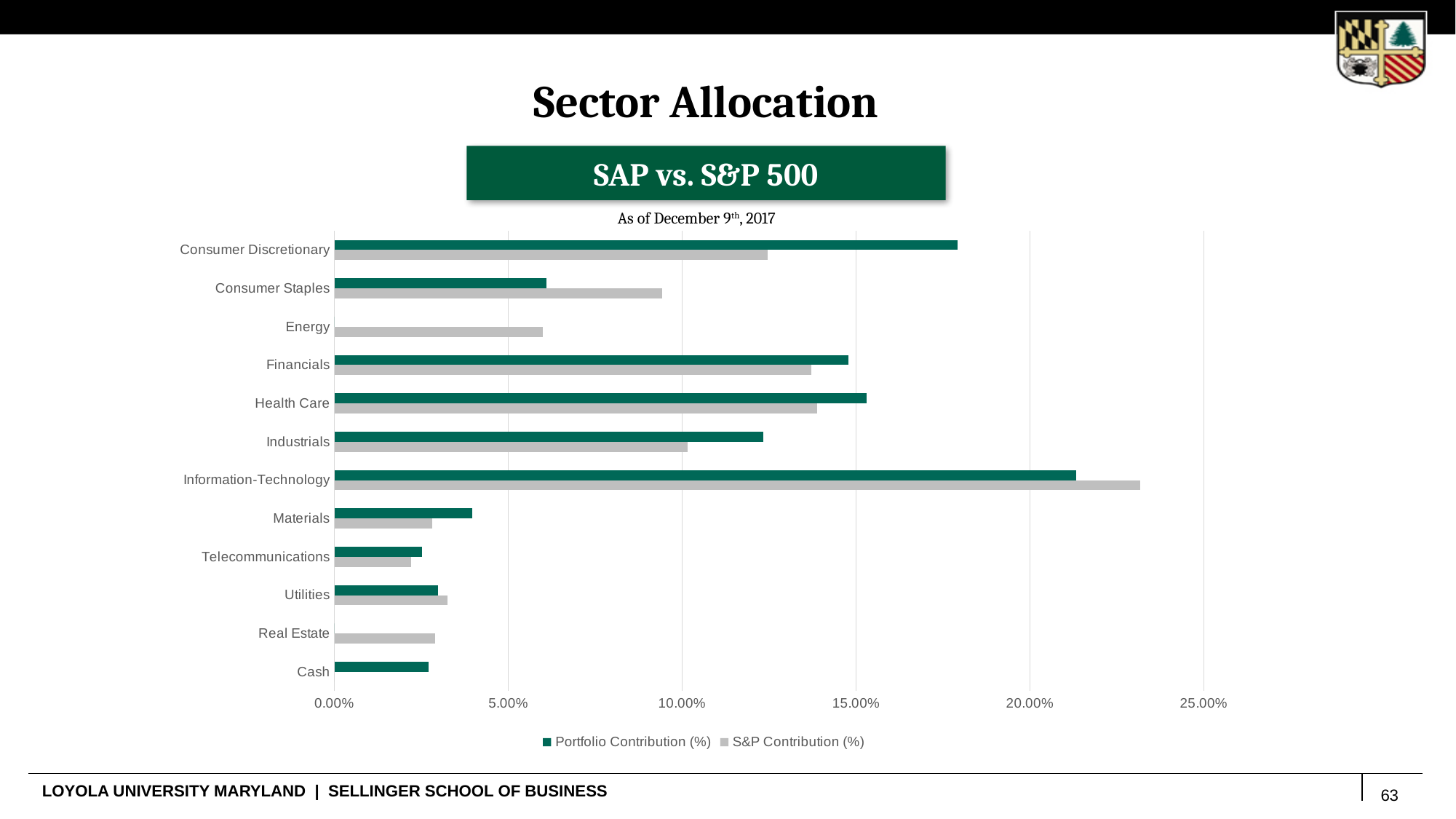
What is the title shown in the green banner above the chart? SAP vs. S&P 500 Is the S&P Contribution (%) for Consumer Staples greater or less than 10.00%? less What kind of chart is shown on the slide? Bar chart Is the Portfolio Contribution (%) for Industrials greater or less than 10.00%? greater For Consumer Staples, which is larger: Portfolio Contribution (%) or S&P Contribution (%)? S&P Contribution (%) Is the S&P Contribution (%) for Information-Technology greater or less than 20.00%? greater For Consumer Discretionary, which is larger: Portfolio Contribution (%) or S&P Contribution (%)? Portfolio Contribution (%) How many series does the legend list? 2 How many sectors (categories) are shown on the y axis of the chart? 12 Which sector has the highest Portfolio Contribution (%)? Information-Technology Which sector has the highest S&P Contribution (%)? Information-Technology